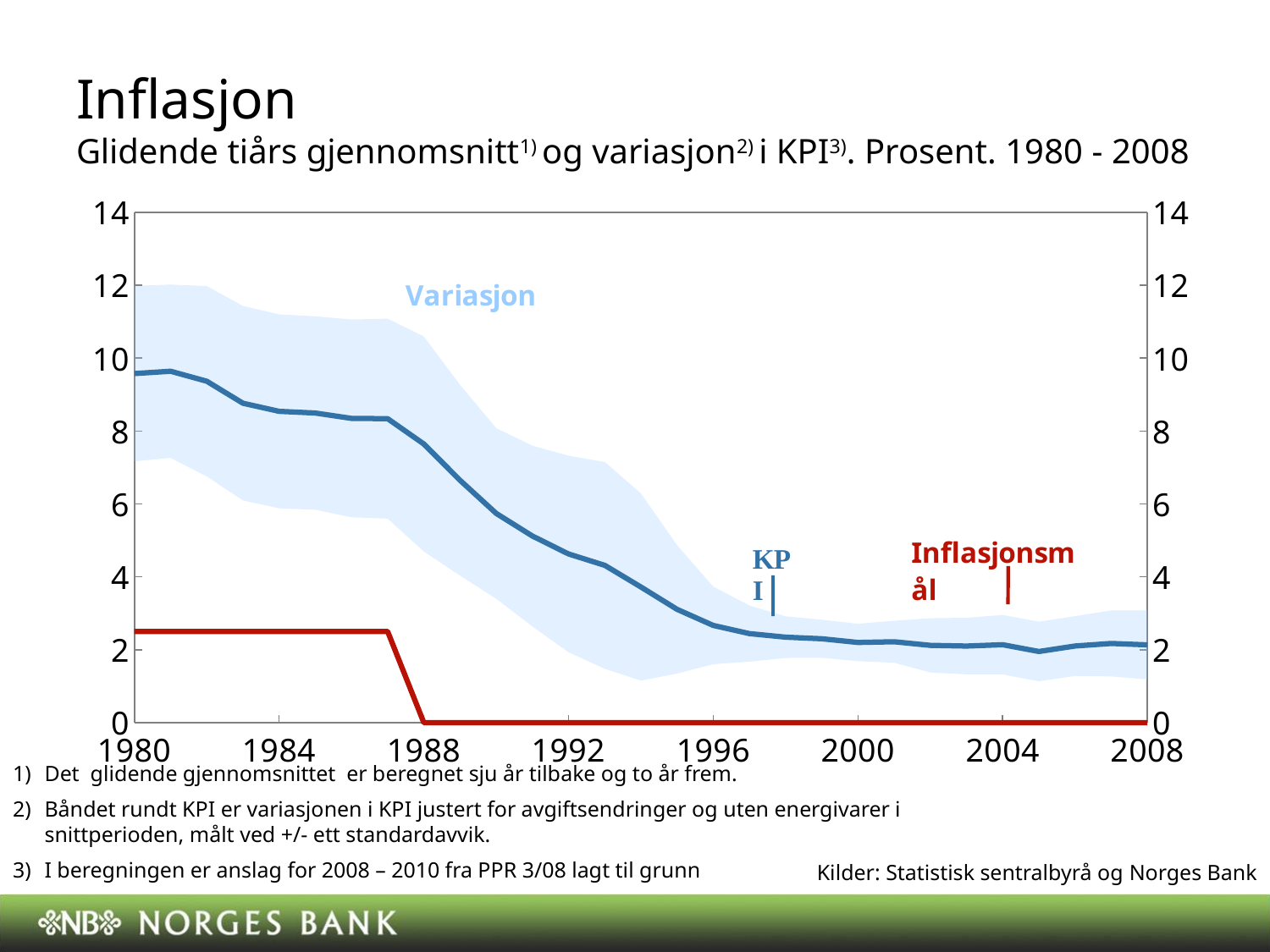
Is the KPI value in 1980 greater or less than 8? greater What is the label of the light blue shaded band? Variasjon What is the title of the chart? Inflasjon Is the KPI value in 2008 greater or less than 4? less How many year labels are shown on the x axis? 8 Is the KPI value in 1988 greater or less than 6? greater Which is larger, the KPI value in 1984 or in 1996? 1984 Does the KPI line rise or fall from 1980 to 2008? fall What kind of chart is shown on the slide? line chart with a shaded area band (combination area and line chart)